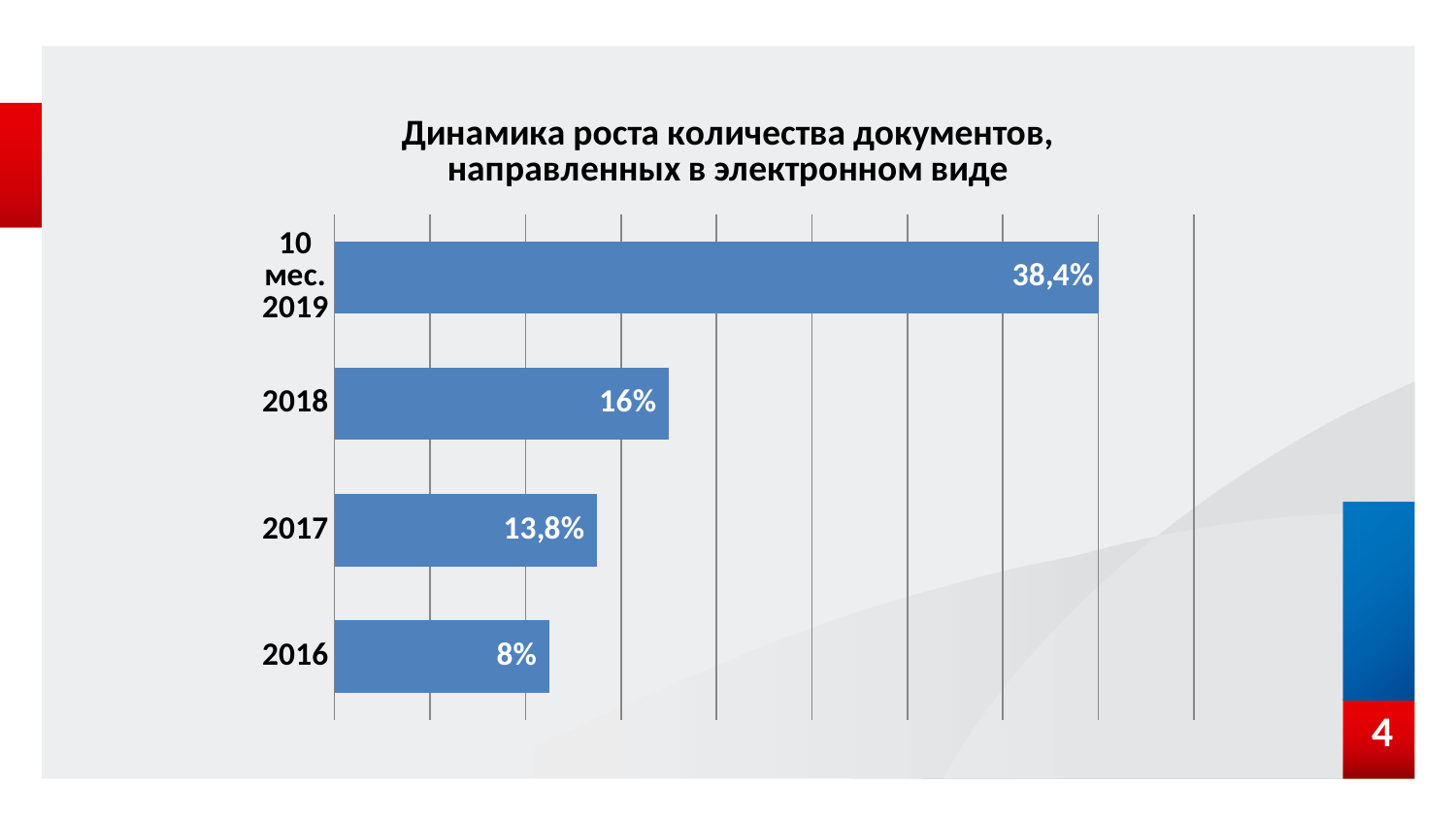
How many categories are shown in the chart? 4 What is the value for 2017? 13,8% Which category has the highest value? 10 мес. 2019 What is the value for 10 мес. 2019? 38,4% Which category has the lowest value? 2016 What kind of chart is shown on the slide? Bar chart What is the value for 2016? 8% Do the values rise or fall from 2016 to 10 мес. 2019? Rise What is the difference between the values for 2017 and 2016? 5,8% What is the difference between the values for 10 мес. 2019 and 2018? 22,4% What is the value for 2018? 16% Which is larger, the value for 2018 or the value for 2017? 2018